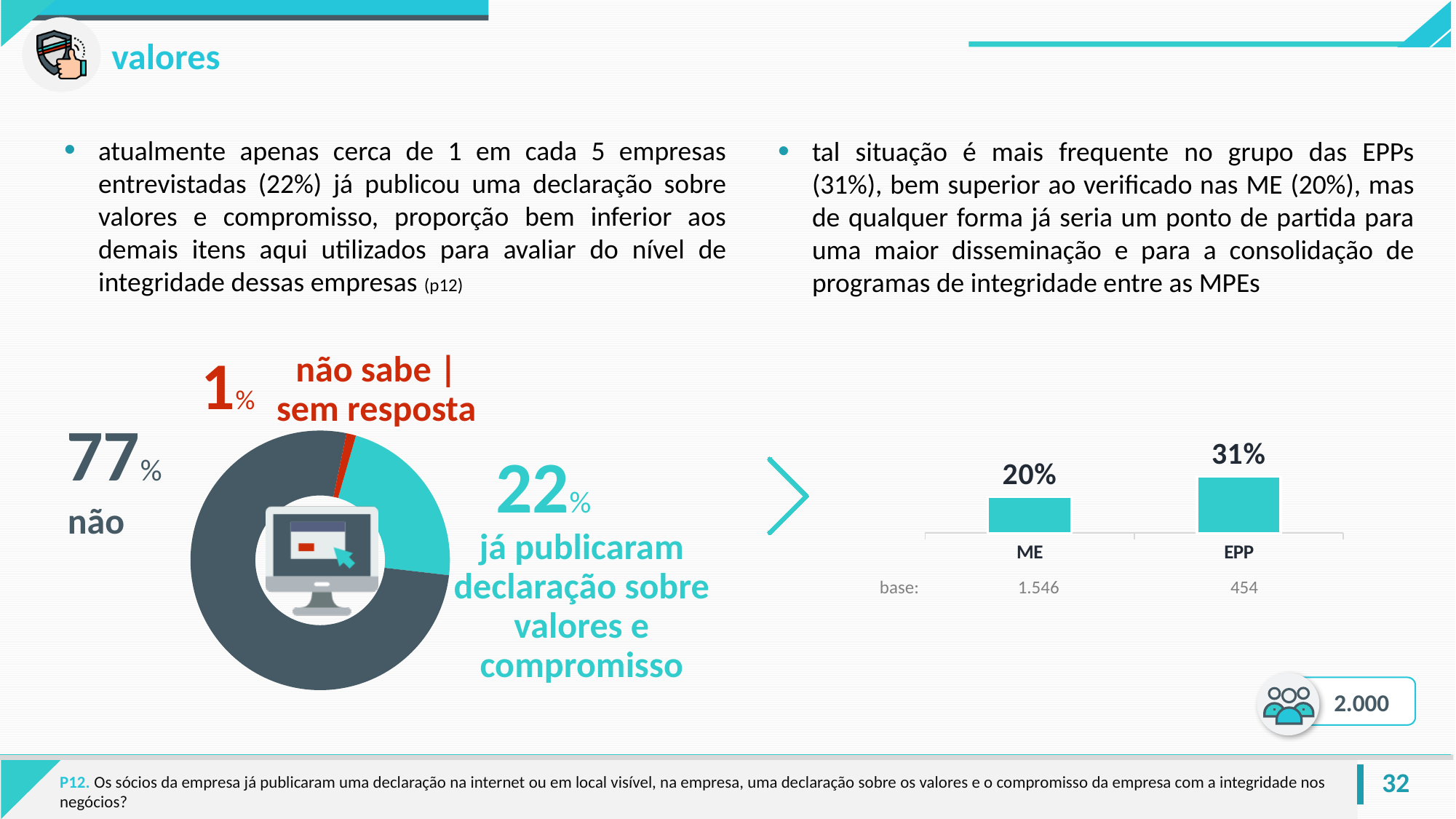
In the pie chart on the left, what share corresponds to "não sabe | sem resposta"? 1% In the pie chart on the left, what is the difference in percentage points between "não" and "já publicaram declaração sobre valores e compromisso"? 55 In the pie chart on the left, which category has the largest slice? não In the bar chart on the right, what is the difference in percentage points between EPP and ME? 11 In the pie chart on the left, what share of companies answered "não"? 77% In the pie chart on the left, which category has the smallest slice? não sabe | sem resposta In the bar chart on the right, what is the value for ME? 20% What kind of chart is shown on the right side of the slide? bar chart In the pie chart on the left, what share of companies "já publicaram declaração sobre valores e compromisso"? 22% In the bar chart on the right, which category has the higher value, ME or EPP? EPP In the bar chart on the right, what is the value for EPP? 31% In the pie chart on the left, how many slices are there? 3